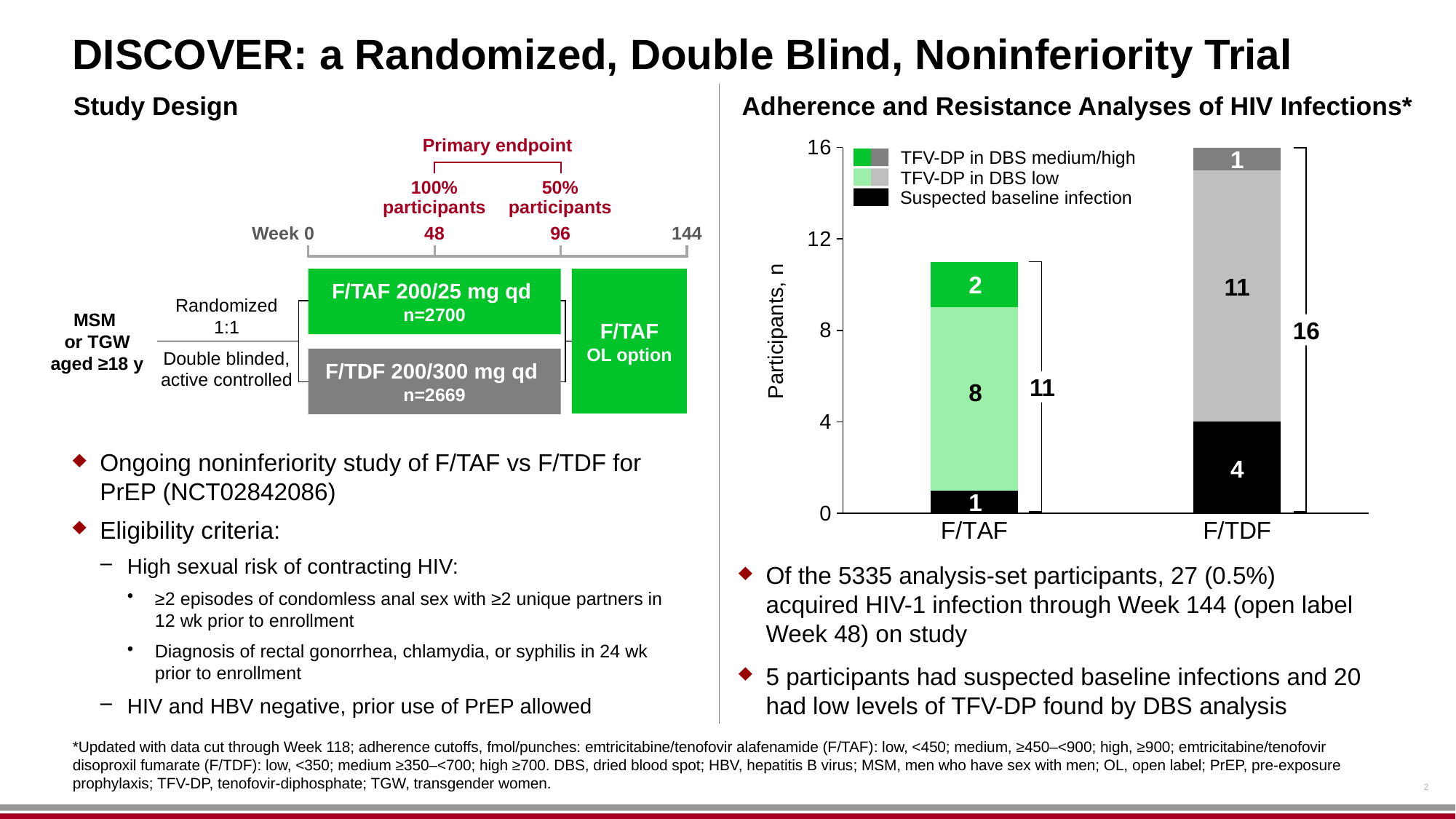
How many series does the legend of the Adherence and Resistance Analyses chart list? 3 How many groups are shown on the x axis of the Adherence and Resistance Analyses chart? 2 In the Adherence and Resistance Analyses chart, what is the total number of participants in the F/TDF bar? 16 In the Adherence and Resistance Analyses chart, how many F/TAF participants had TFV-DP in DBS medium/high? 2 In the Adherence and Resistance Analyses chart, what is the total number of participants in the F/TAF bar? 11 What is the y-axis label of the Adherence and Resistance Analyses chart? Participants, n In the Adherence and Resistance Analyses chart, what is the difference between the F/TDF total and the F/TAF total? 5 In the Adherence and Resistance Analyses chart, which group has the higher total number of participants, F/TAF or F/TDF? F/TDF In the Adherence and Resistance Analyses chart, how many suspected baseline infections were there in the F/TDF group? 4 In the Adherence and Resistance Analyses chart, how many F/TDF participants had TFV-DP in DBS low? 11 In the Adherence and Resistance Analyses chart, how many participants in the F/TAF group had suspected baseline infection? 1 What kind of chart is shown under 'Adherence and Resistance Analyses of HIV Infections'? Stacked bar chart